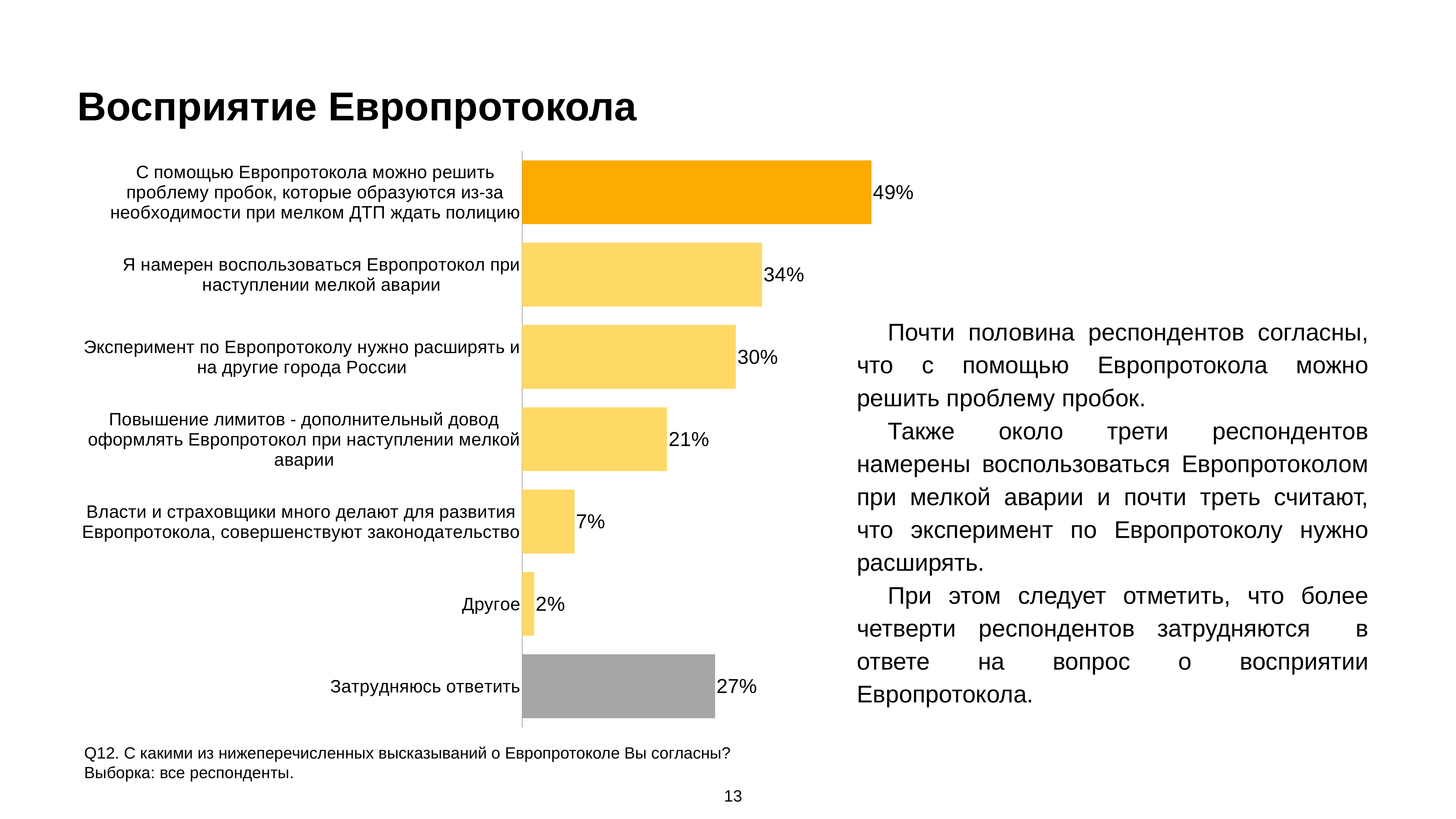
What kind of chart is shown on the slide? Bar chart What percentage of respondents think the Europrotocol experiment should be extended to other cities of Russia? 30% How many categories (bars) does the chart show? 7 Which is larger: the value for "Затрудняюсь ответить" or the value for "Повышение лимитов - дополнительный довод оформлять Европротокол при наступлении мелкой аварии"? Затрудняюсь ответить What is the difference between the value for "Я намерен воспользоваться Европротокол при наступлении мелкой аварии" and the value for "Эксперимент по Европротоколу нужно расширять и на другие города России"? 4% Which statement has the highest share of agreement? С помощью Европротокола можно решить проблему пробок, которые образуются из-за необходимости при мелком ДТП ждать полицию What percentage of respondents agree that the Europrotocol can solve the problem of traffic jams caused by waiting for police after a minor accident? 49% Which category has the lowest value? Другое What is the value for "Затрудняюсь ответить"? 27% Which bar is coloured grey? Затрудняюсь ответить What is the value for "Я намерен воспользоваться Европротокол при наступлении мелкой аварии"? 34% What is the value for "Власти и страховщики много делают для развития Европротокола, совершенствуют законодательство"? 7%